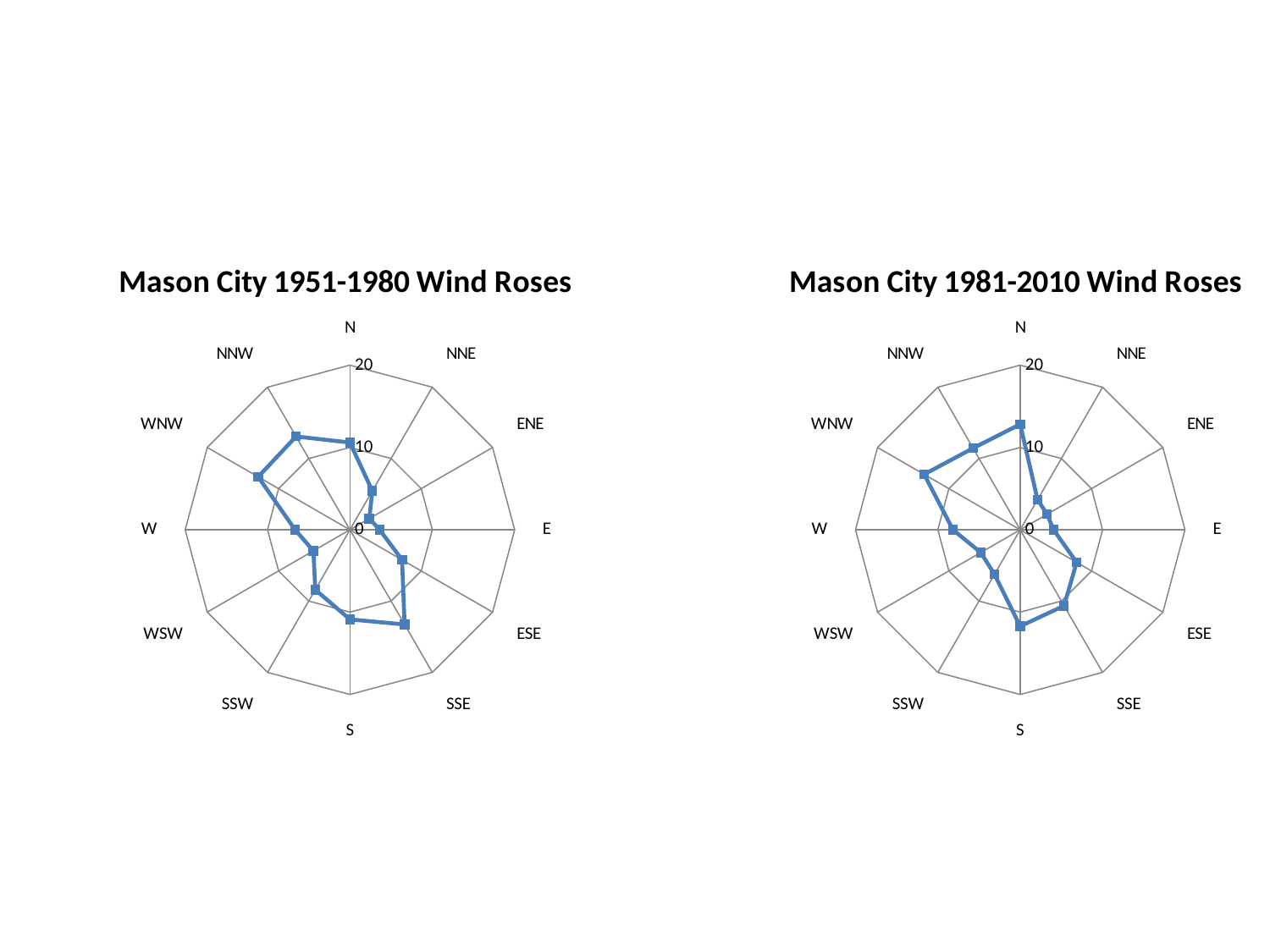
What is the title of the chart on the right side of the slide? Mason City 1981-2010 Wind Roses On the Mason City 1951-1980 Wind Roses chart, which is larger, the value for SSE or the value for E? SSE On the Mason City 1981-2010 Wind Roses chart, is the value for WSW greater or less than 10? less How many compass directions are plotted on the Mason City 1981-2010 Wind Roses chart? 12 On the Mason City 1951-1980 Wind Roses chart, is the value for ENE greater or less than 10? less On the Mason City 1951-1980 Wind Roses chart, is the value for WNW greater or less than 10? greater What is the highest value labelled on the radial axis of the Mason City 1951-1980 Wind Roses chart? 20 On the Mason City 1981-2010 Wind Roses chart, which is larger, the value for N or the value for NNE? N What kind of chart is the Mason City 1951-1980 Wind Roses chart? radar chart